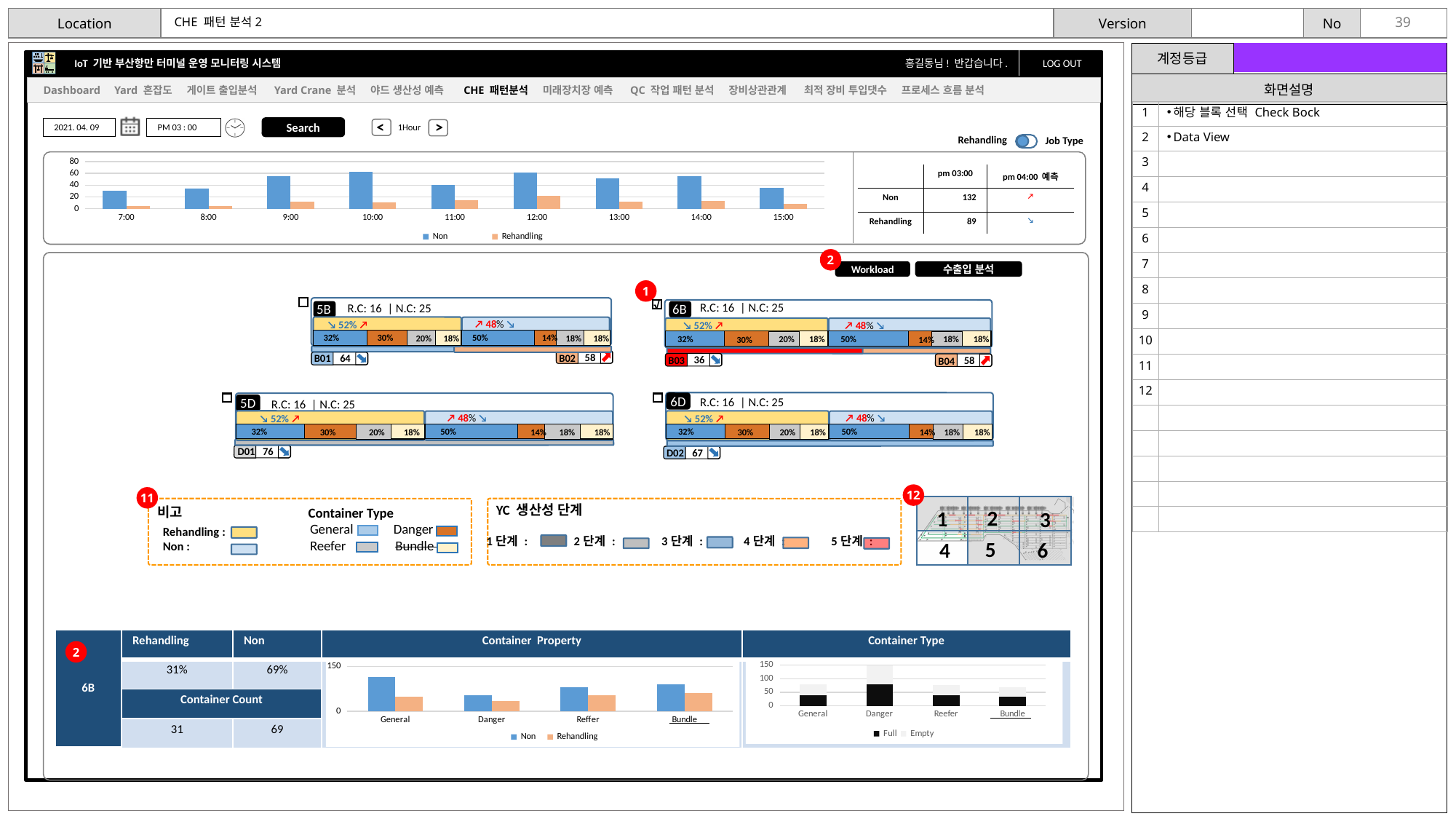
How many time points are shown on the x axis of the top hourly chart? 9 In the Container Property chart, which is larger: the Rehandling bar for Bundle or the Rehandling bar for Danger? Bundle In the Container Type chart, is the Full value for Danger greater or less than 50? greater In the Container Property chart, which category has the highest Non bar? General In the top hourly chart, is the Rehandling value at 7:00 greater or less than 20? less In the top hourly chart, at which time is the Rehandling bar highest? 12:00 How many categories are shown on the x axis of the Container Property chart? 4 In the top hourly chart, which is larger: the Non bar at 10:00 or the Non bar at 11:00? 10:00 What are the two legend entries of the top hourly chart? Non, Rehandling How many series does the legend of the top hourly chart list? 2 In the top hourly chart, is the Non value at 9:00 greater or less than 40? greater What kind of chart is the hourly chart at the top of the slide (7:00 to 15:00)? bar chart